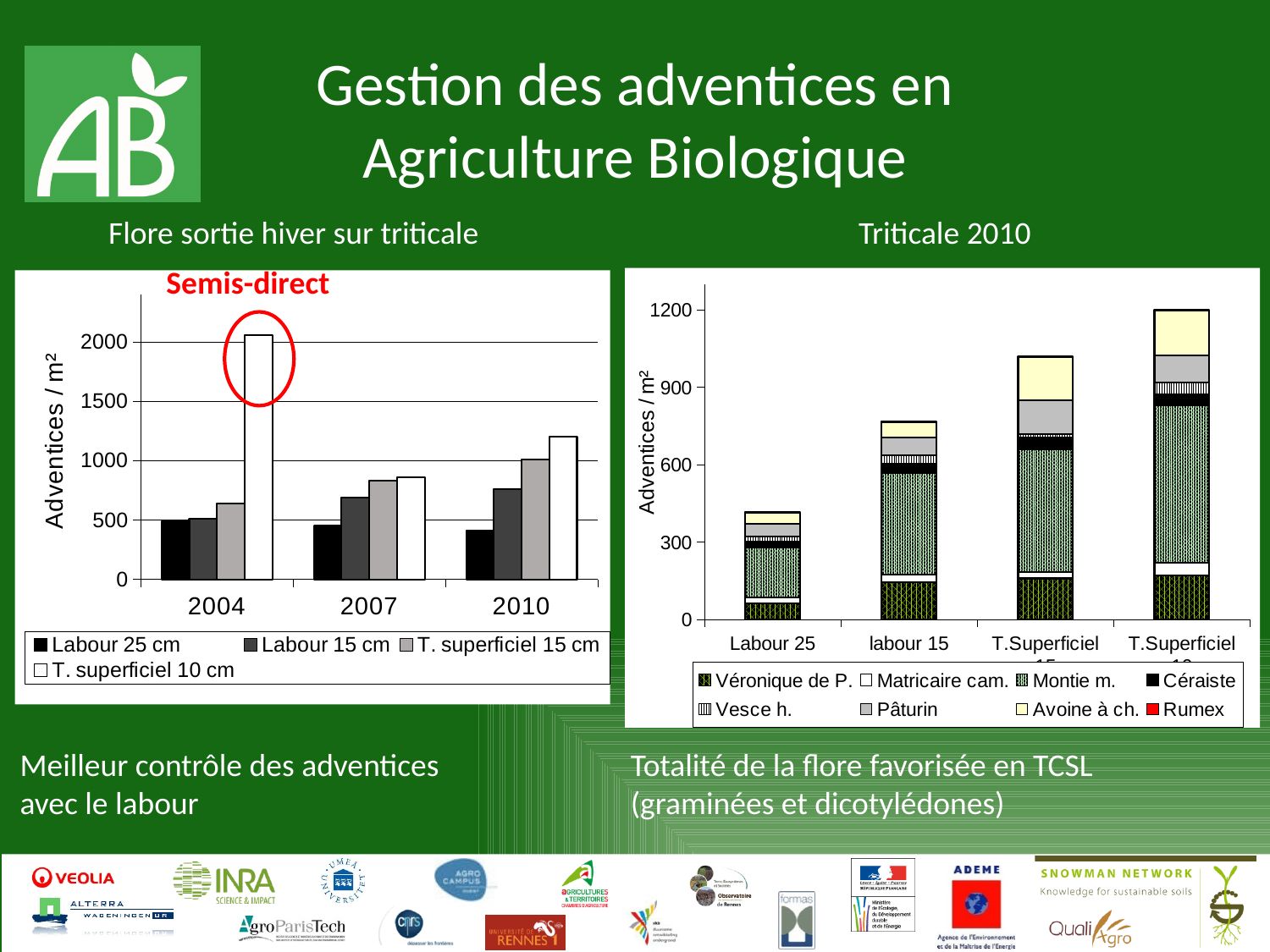
In the 'Flore sortie hiver sur triticale' chart, how many years are shown on the x axis? 3 In the 'Flore sortie hiver sur triticale' chart, does the value for Labour 25 cm rise or fall from 2004 to 2010? fall In the 'Flore sortie hiver sur triticale' chart, is the value for T. superficiel 10 cm in 2004 greater or less than 1500? greater In the 'Triticale 2010' chart, which category has the lowest total stacked bar? Labour 25 In the 'Flore sortie hiver sur triticale' chart, how many series does the legend list? 4 In the 'Triticale 2010' chart, how many categories are shown on the x axis? 4 In the 'Flore sortie hiver sur triticale' chart, which is larger in 2010: Labour 15 cm or T. superficiel 15 cm? T. superficiel 15 cm In the 'Flore sortie hiver sur triticale' chart, is the value for T. superficiel 10 cm in 2010 greater or less than 1000? greater In the 'Flore sortie hiver sur triticale' chart, which series has the highest bar in 2004? T. superficiel 10 cm In the 'Triticale 2010' chart, is the total for labour 15 greater or less than 900? less In the 'Triticale 2010' chart, how many series does the legend list? 8 What type of chart is the 'Flore sortie hiver sur triticale' chart on the left? bar chart